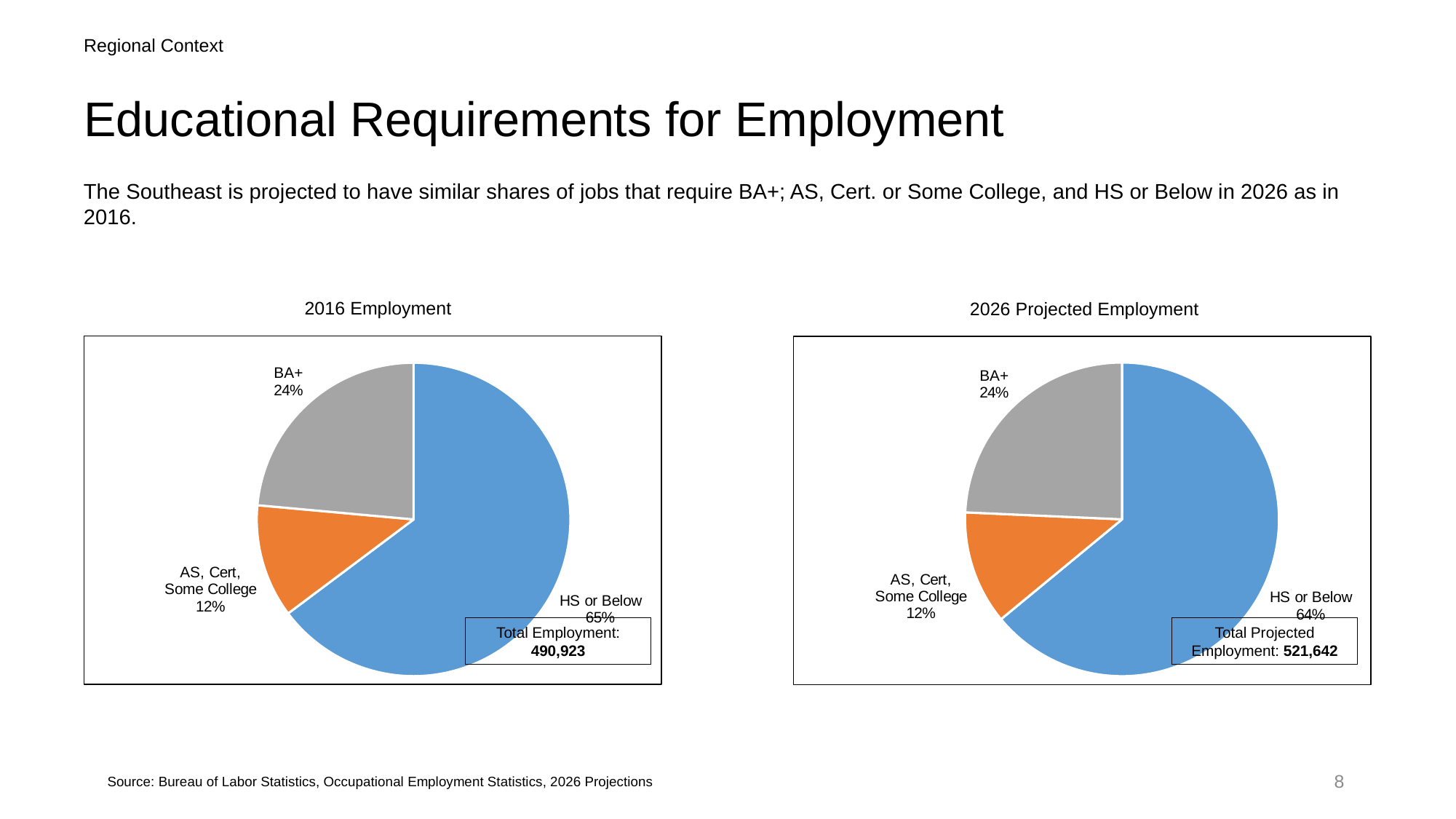
In the 2026 Projected Employment chart, which category has the smallest share? AS, Cert, Some College In the 2026 Projected Employment chart, which is larger: the BA+ share or the AS, Cert, Some College share? BA+ In the 2016 Employment chart, which category has the largest share? HS or Below What is the total employment shown in the 2016 Employment chart? 490,923 In the 2016 Employment chart, what is the difference in percentage points between the BA+ share and the AS, Cert, Some College share? 12 What is the total projected employment shown in the 2026 Projected Employment chart? 521,642 In the 2026 Projected Employment chart, what share of jobs require AS, Cert, Some College? 12% In the 2016 Employment chart, what share of jobs require HS or Below? 65% In the 2026 Projected Employment chart, what share of jobs require HS or Below? 64% In the 2016 Employment chart, what share of jobs require BA+? 24% What type of chart is used for 2026 Projected Employment? Pie chart How many categories does the 2016 Employment pie chart show? 3